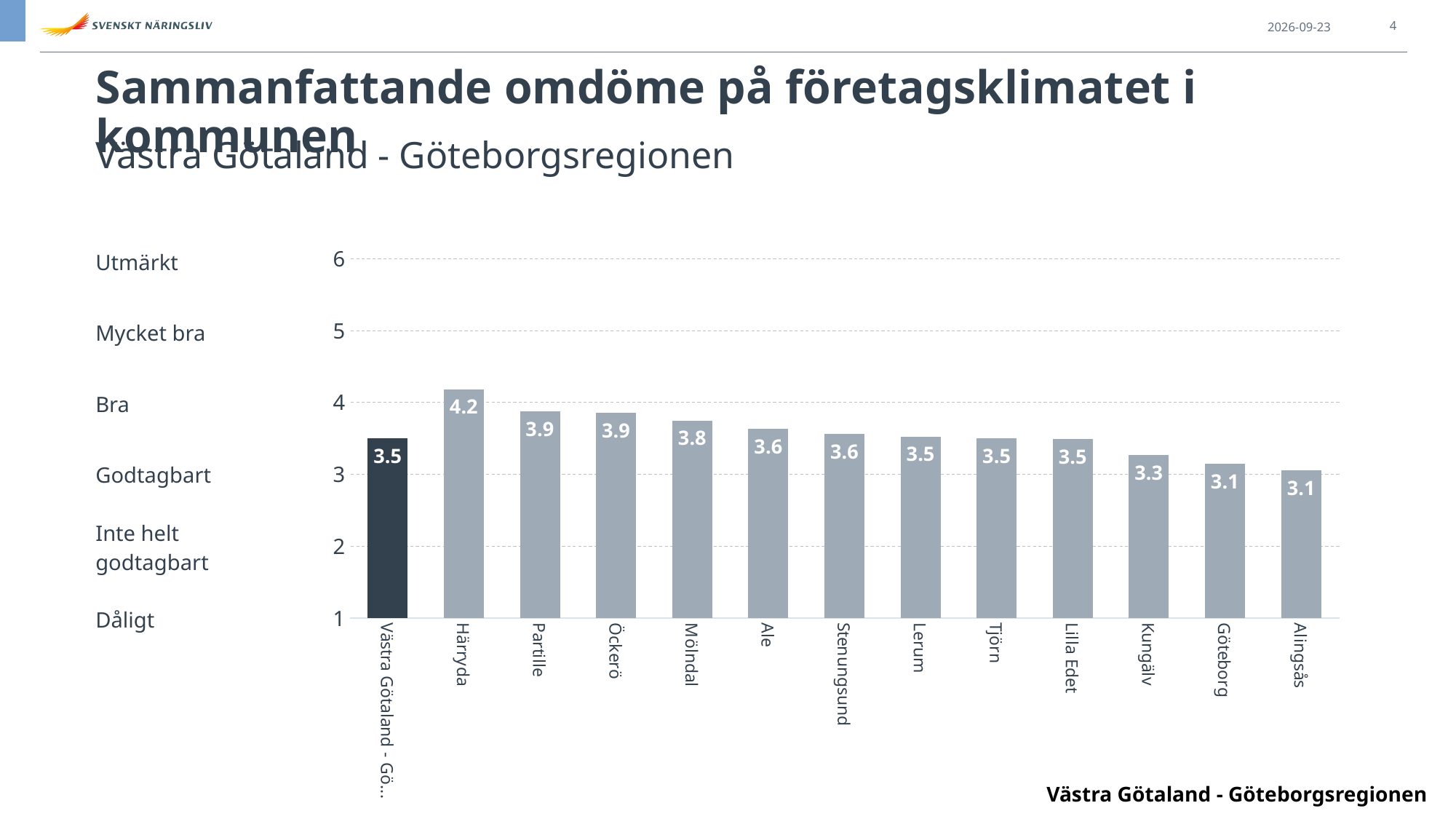
Do the values of the municipality bars rise or fall from Härryda on the left to Alingsås on the right? fall What is the value for Stenungsund? 3.6 Which has the larger value, Mölndal or Ale? Mölndal What is the difference between the values for Härryda and Kungälv? 0.9 Is the value for Härryda greater or less than 4? greater How many bars are shown in the chart? 13 What is the value for Härryda? 4.2 Which municipality has the highest value in the chart? Härryda What is the value for Göteborg? 3.1 What is the value for Kungälv? 3.3 What kind of chart is shown on the slide? bar chart What is the value for Mölndal? 3.8